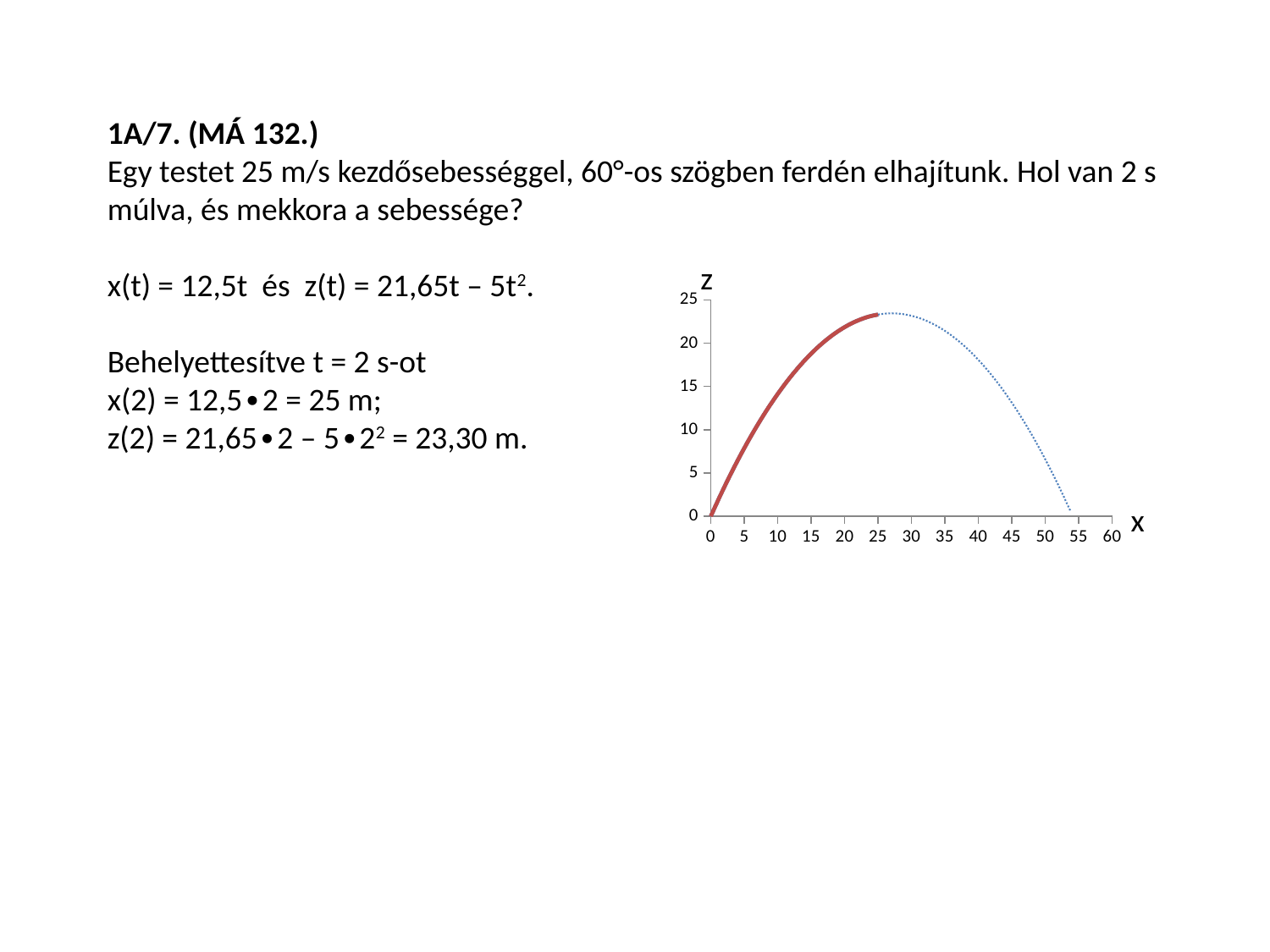
Is the z value of the curve at x = 40 greater or less than 15? greater What is the highest tick value shown on the horizontal axis? 60 Is the z value of the curve at x = 50 greater or less than 10? less What is the highest tick value shown on the vertical axis? 25 What kind of chart is shown on the slide? line chart At what x value does the solid red part of the curve end? 25 Is the z value of the curve at x = 10 greater or less than 10? greater What is the label of the vertical axis of the chart? z How does the z value change along the x axis from x = 0 to x = 25? it rises What is the label of the horizontal axis of the chart? x